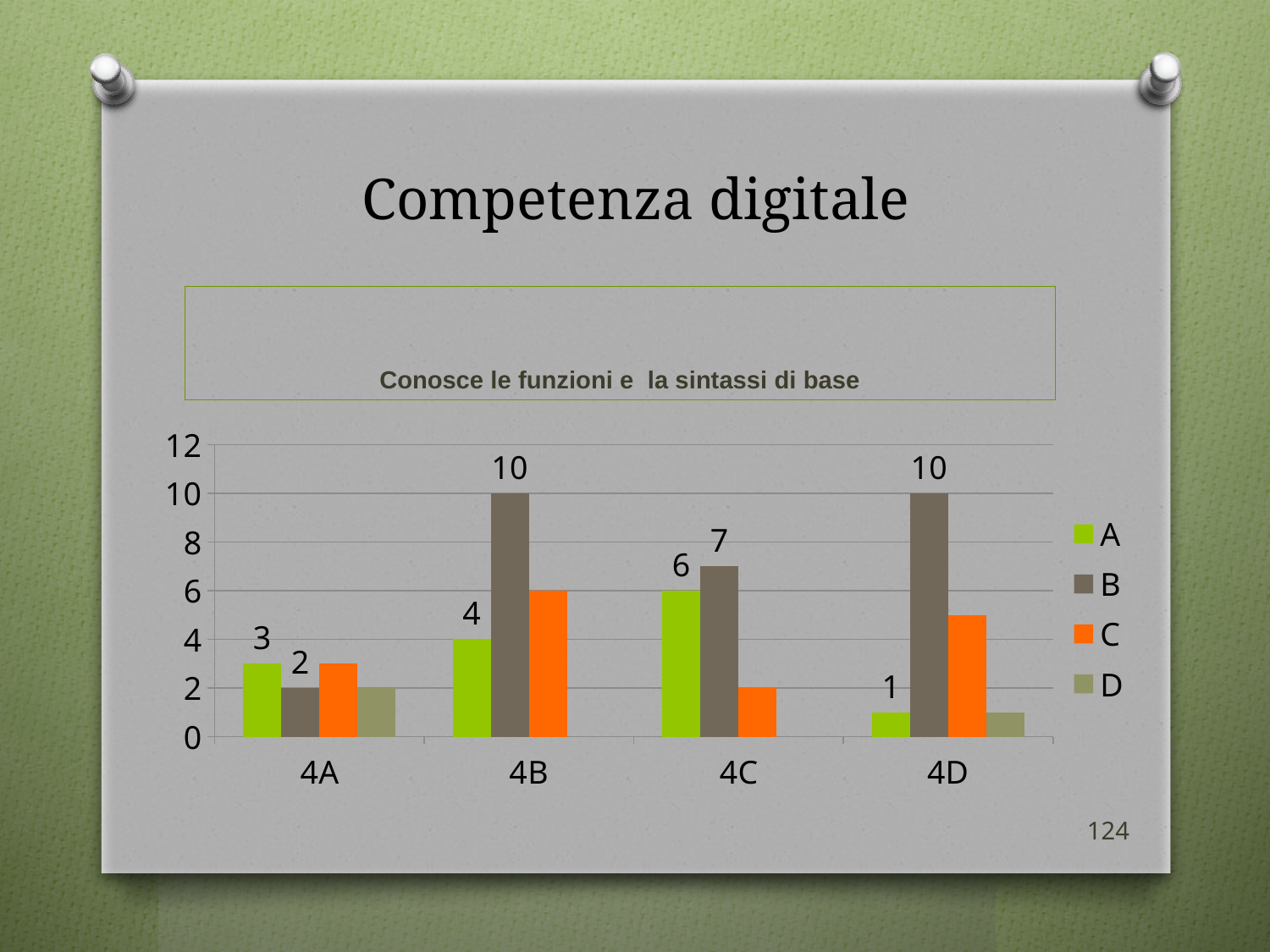
What is the value for series A in category 4C? 6 Which category has the highest value for series A? 4C What is the value for series A in category 4D? 1 What kind of chart is shown on the slide? bar chart In category 4C, which is larger, series A or series B? B What is the value for series B in category 4B? 10 Is the value for series C in category 4D greater or less than 4? greater How many categories are shown on the x axis? 4 What is the difference between series B and series A in category 4B? 6 What is the value for series B in category 4A? 2 Which category has the lowest value for series A? 4D How many series does the legend list? 4